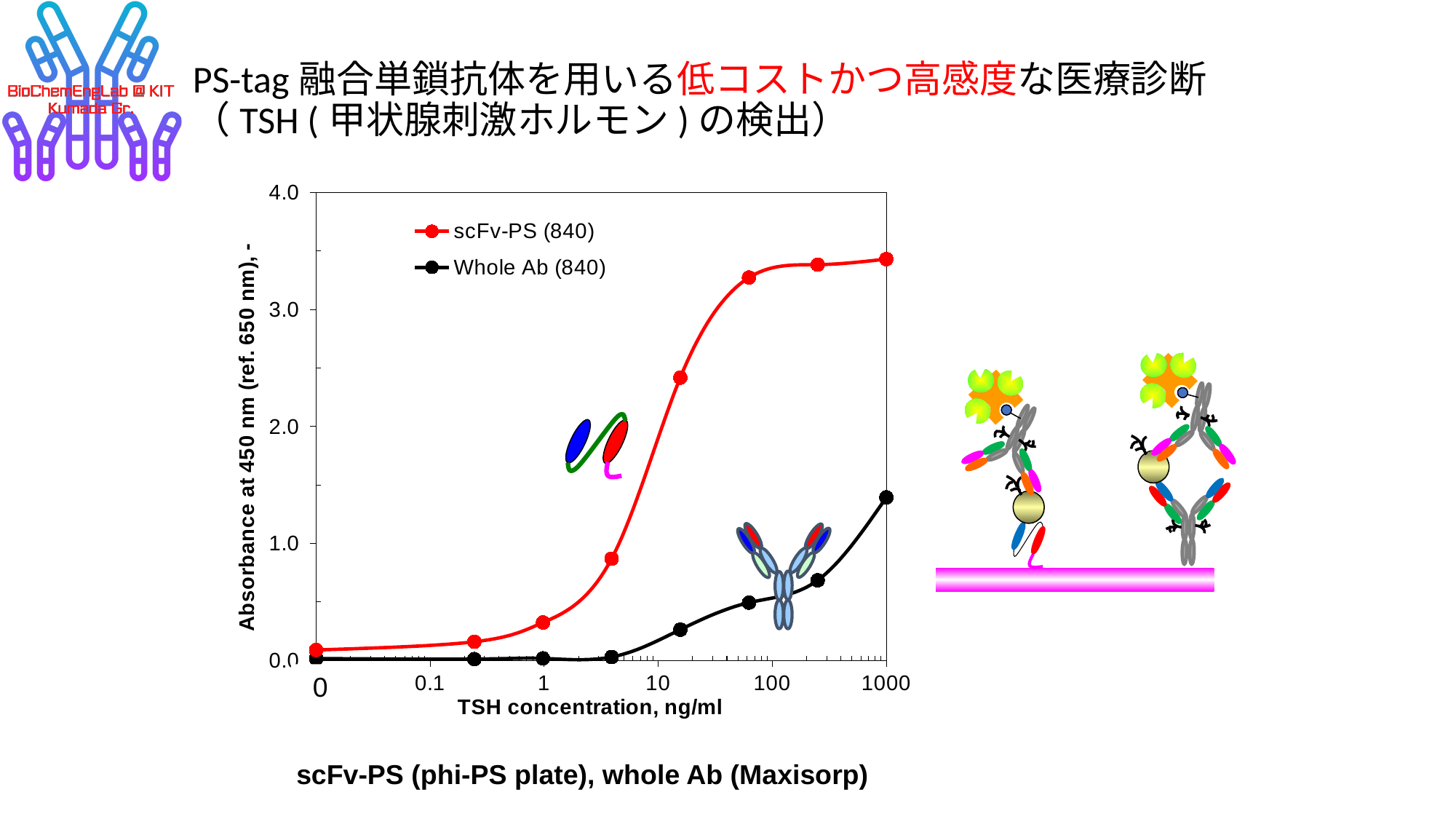
What are the two series named in the legend? scFv-PS (840) and Whole Ab (840) How many series does the legend list? 2 Is the absorbance for scFv-PS (840) at 1000 ng/ml greater or less than 3.0? greater What is the label of the x axis? TSH concentration, ng/ml Which series has the higher absorbance at 1000 ng/ml TSH, scFv-PS (840) or Whole Ab (840)? scFv-PS (840) Does the absorbance for scFv-PS (840) rise or fall as TSH concentration increases? rise Is the absorbance for Whole Ab (840) at 1000 ng/ml greater or less than 2.0? less Is the absorbance for Whole Ab (840) at 10 ng/ml greater or less than 1.0? less What kind of chart is shown on the slide? line chart Which series reaches a plateau near 3.4 at high TSH concentrations? scFv-PS (840) Does the absorbance for Whole Ab (840) rise or fall as TSH concentration increases? rise